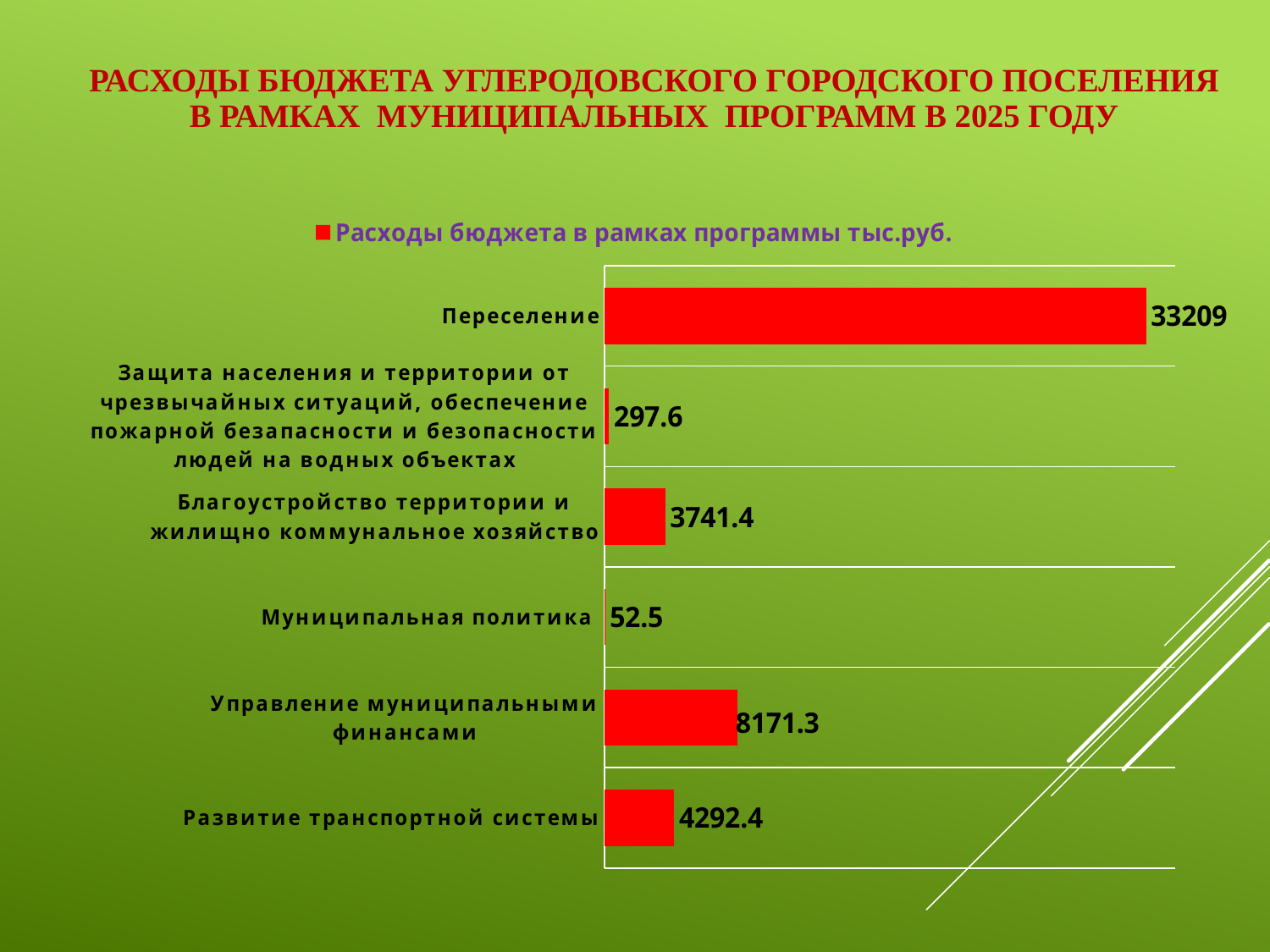
What is the value for Переселение? 33209 What is the difference between Управление муниципальными финансами and Развитие транспортной системы? 3878.9 What is the difference between Развитие транспортной системы and Благоустройство территории и жилищно коммунальное хозяйство? 551 What is the value for Муниципальная политика? 52.5 Which is larger: Благоустройство территории и жилищно коммунальное хозяйство or Развитие транспортной системы? Развитие транспортной системы How many categories are shown in the chart? 6 What is the value for Управление муниципальными финансами? 8171.3 What is the value for Развитие транспортной системы? 4292.4 Which category has the highest value? Переселение What kind of chart is shown on the slide? Bar chart Which category has the lowest value? Муниципальная политика What is the legend entry of the chart? Расходы бюджета в рамках программы тыс.руб.